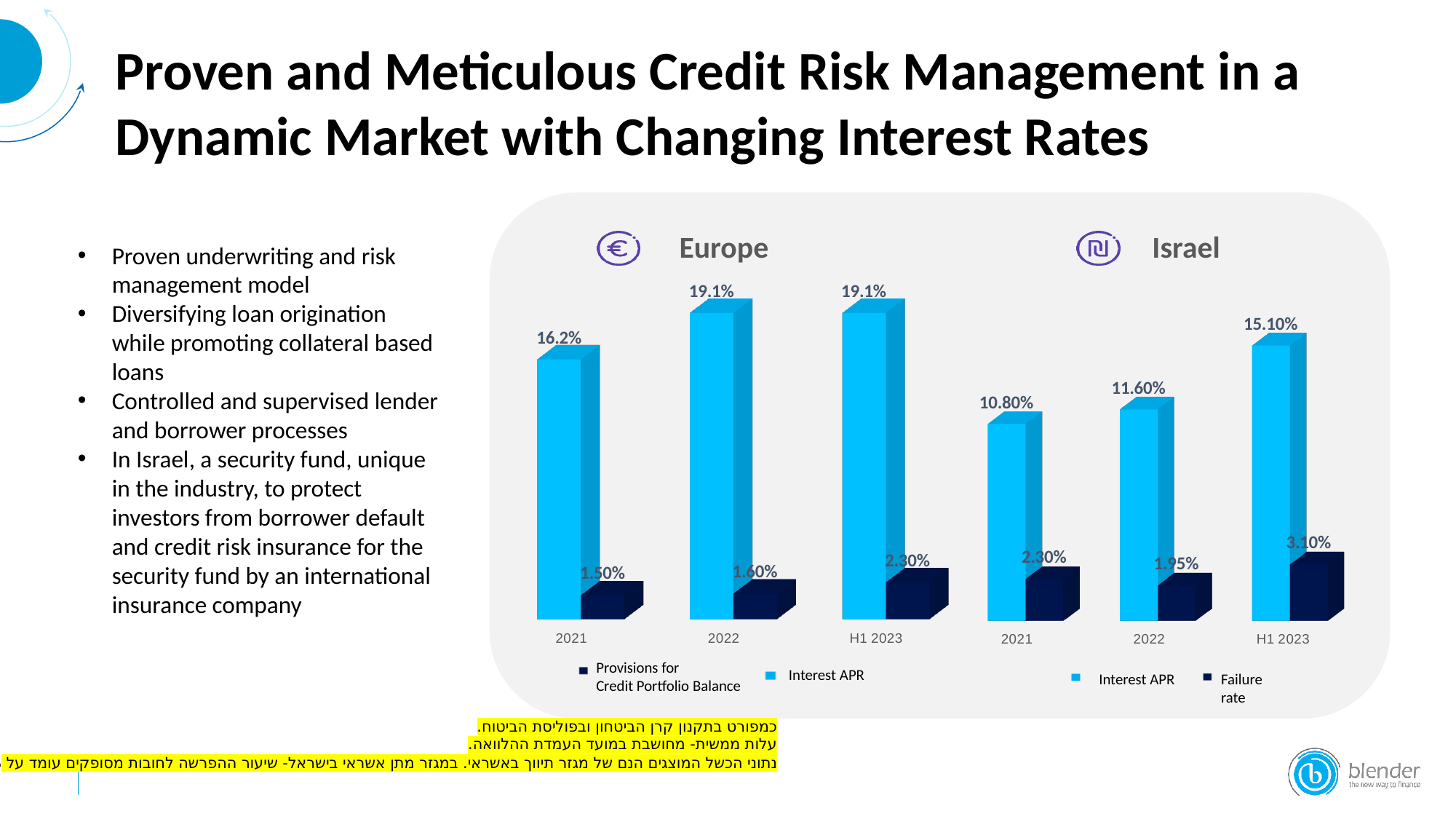
In the Europe chart, what is the Interest APR for 2021? 16.2% What type of chart is the Israel chart? bar chart How many periods are shown on the x axis of the Israel chart? 3 In the Europe chart, which period has the lowest Interest APR? 2021 In the Israel chart, which period has the highest Interest APR? H1 2023 In the Europe chart, is the Interest APR for 2022 higher or lower than for 2021? higher In the Israel chart, what is the Failure rate for 2022? 1.95% In the Israel chart, what is the Interest APR for H1 2023? 15.10% In the Israel chart, what is the difference between the Interest APR for H1 2023 and 2021? 4.30% In the Europe chart, what is the Provisions for Credit Portfolio Balance value for H1 2023? 2.30% In the Israel chart, which period has the lowest Failure rate? 2022 How many series does the legend of the Europe chart list? 2